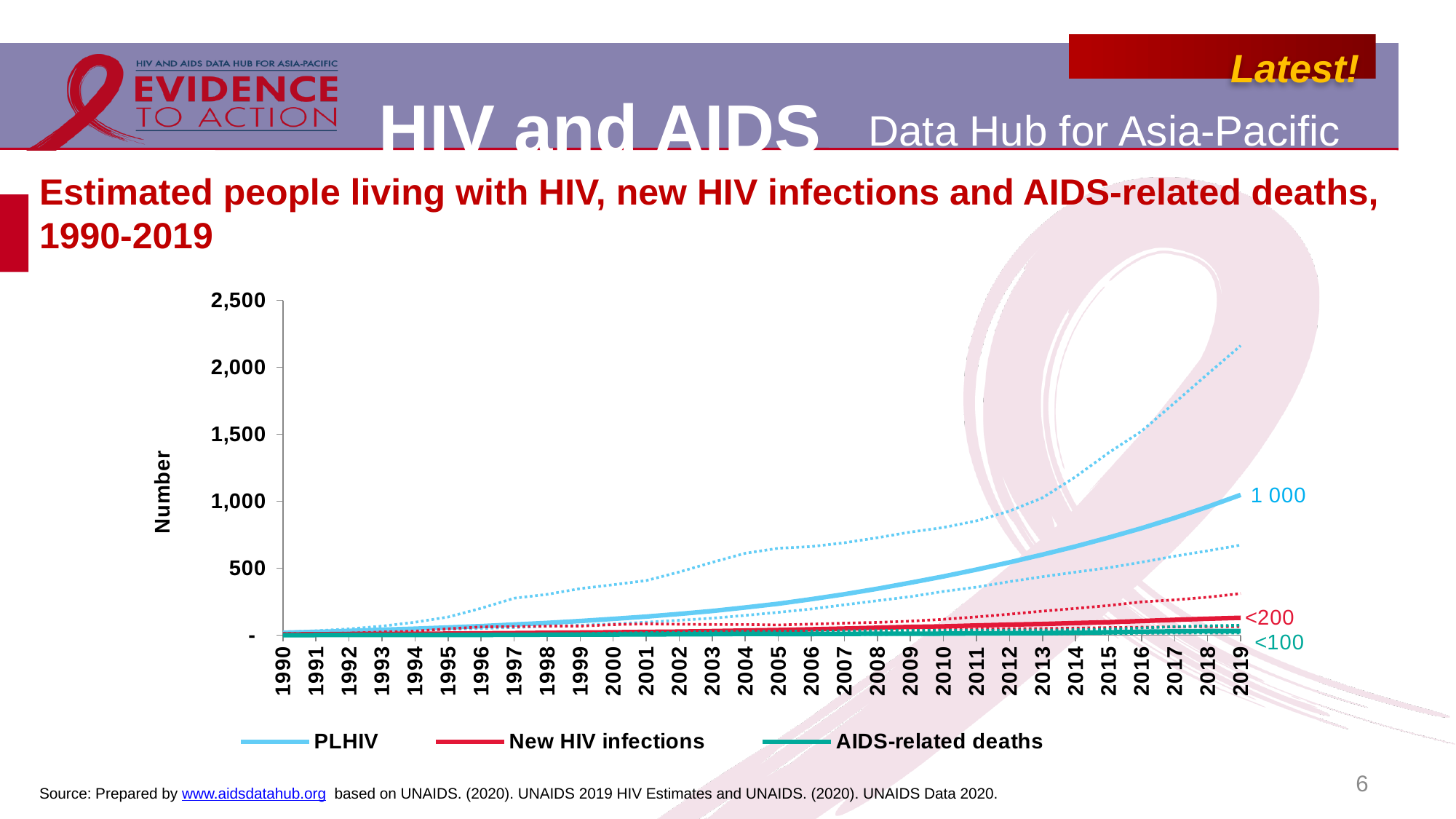
What is the labelled value of the PLHIV line in 2019? 1 000 What kind of chart is shown on the slide? Line chart Which series has the highest value in 2019? PLHIV Which series has the lowest value in 2019? AIDS-related deaths Is the value of the PLHIV line in 2010 greater or less than 500? less What is the label on the y axis? Number What is the labelled value of the AIDS-related deaths line in 2019? <100 What is the labelled value of the New HIV infections line in 2019? <200 How many years are shown along the x axis? 30 How many series does the legend list? 3 In 2019, which is larger: PLHIV or New HIV infections? PLHIV Does the PLHIV line rise or fall from 1990 to 2019? Rise